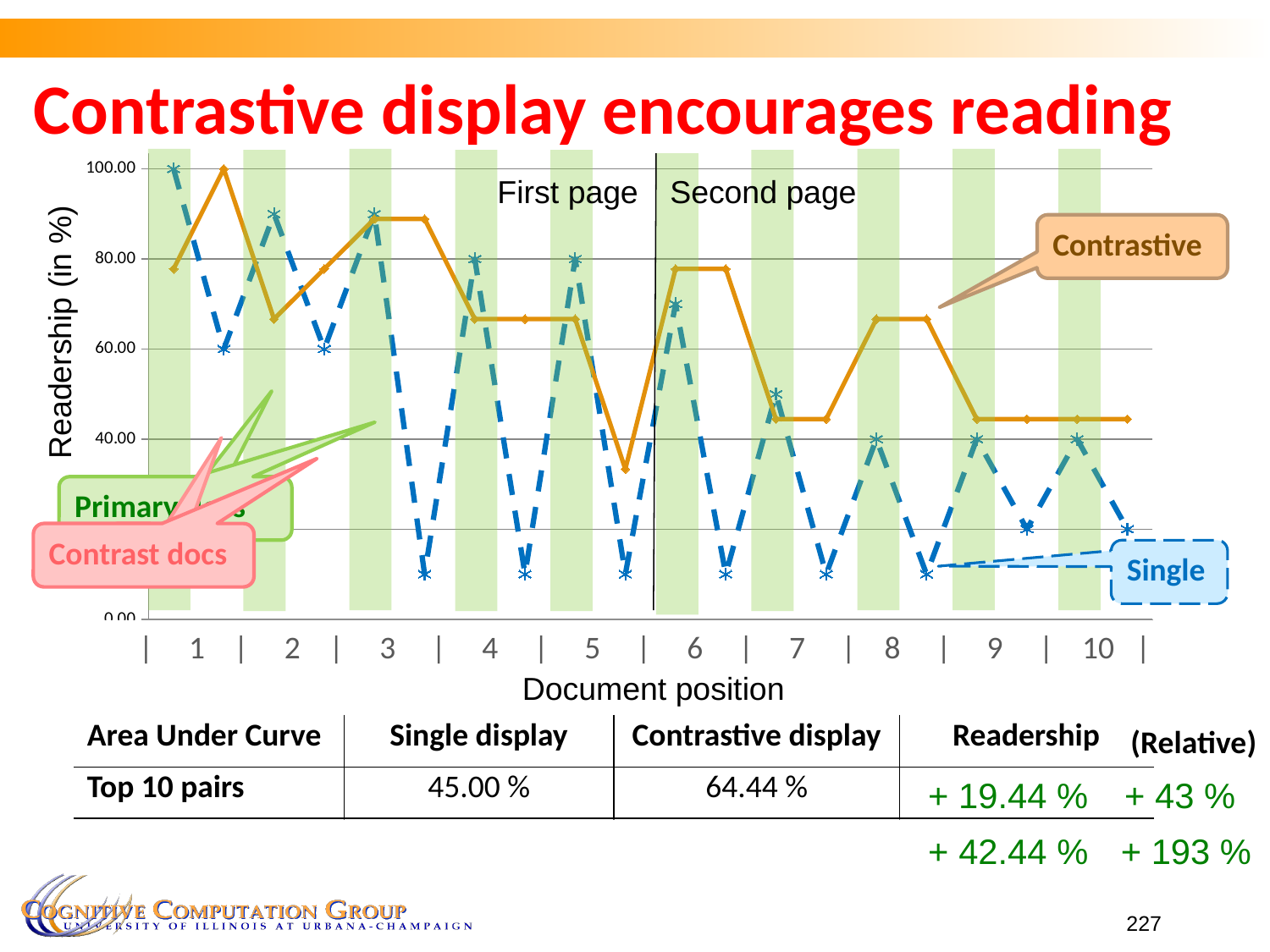
What is the label of the y axis of the chart? Readership (in %) What kind of chart is shown on the slide? line chart At the second point of document position 7, which series has the higher readership, Contrastive or Single? Contrastive Is the Contrastive value at the end of document position 5 greater or less than 40? less Does the Contrastive series rise or fall overall from document position 6 to document position 10? fall Is the Contrastive value at document position 6 greater or less than 60? greater Is the second Single value at document position 3 greater or less than 20? less How many document positions are labelled on the x axis of the chart? 10 Which series is drawn as a blue dashed line, Contrastive or Single? Single How many series are plotted in the chart? 2 At the second point of document position 8, which series has the lower readership, Contrastive or Single? Single